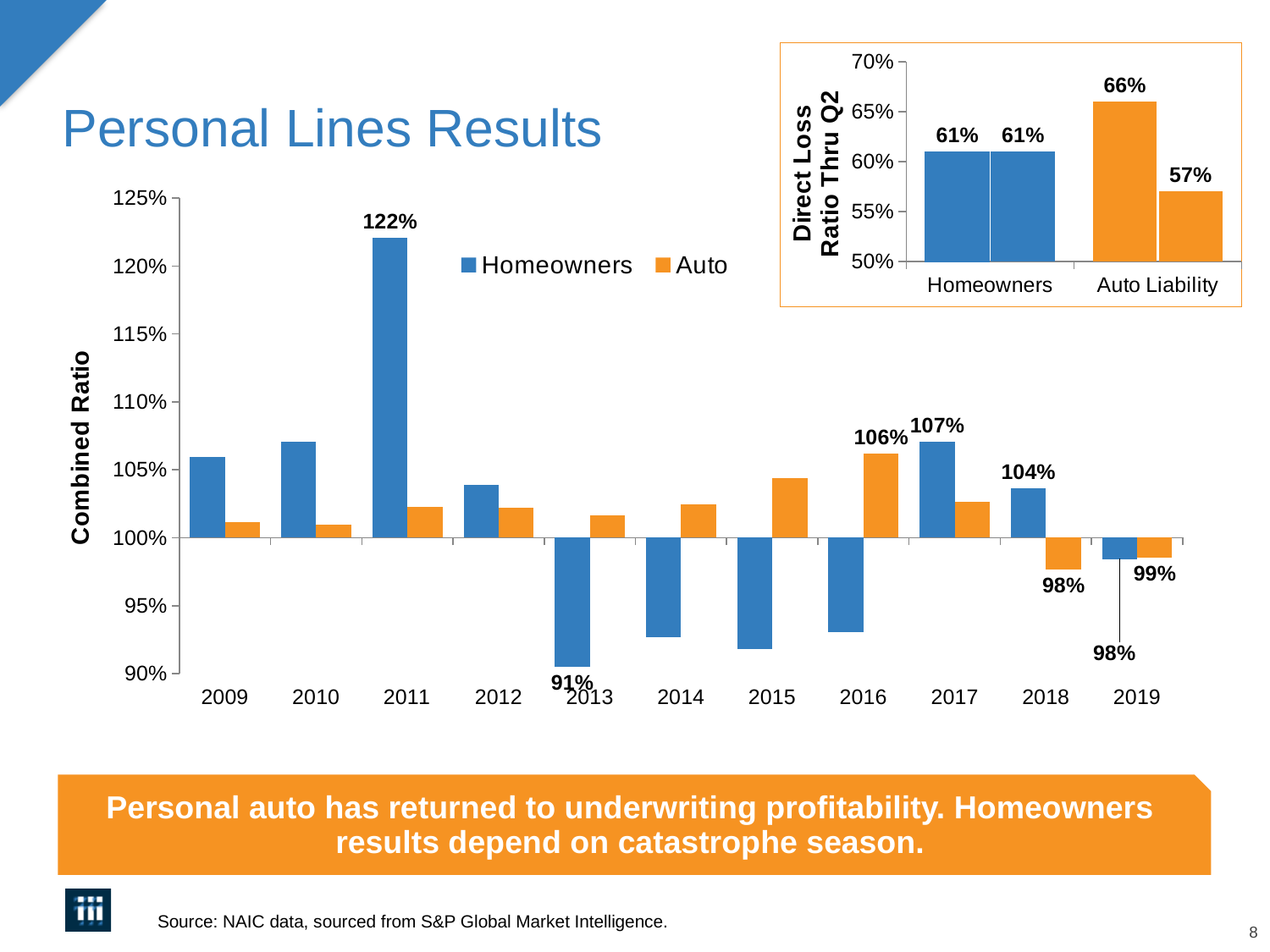
In the Combined Ratio chart, what was the Homeowners combined ratio in 2011? 122% In the Combined Ratio chart, what was the Auto combined ratio in 2016? 106% In the Direct Loss Ratio Thru Q2 chart, what is the value of the tallest Auto Liability bar? 66% In the Combined Ratio chart, is the Homeowners combined ratio in 2014 greater or less than 95%? less In the Combined Ratio chart, how many years are shown on the x axis? 11 In the Combined Ratio chart, which year had the highest Homeowners combined ratio? 2011 In the Combined Ratio chart, what is the difference between the Homeowners combined ratio in 2011 and in 2013? 31 percentage points In the Combined Ratio chart, what was the Homeowners combined ratio in 2013? 91% In the Direct Loss Ratio Thru Q2 chart, what is the difference between the two Auto Liability bars? 9 percentage points In the Combined Ratio chart, how many series does the legend list? 2 In the Combined Ratio chart, what was the Auto combined ratio in 2019? 99% In the Combined Ratio chart, which year had the lowest Homeowners combined ratio? 2013